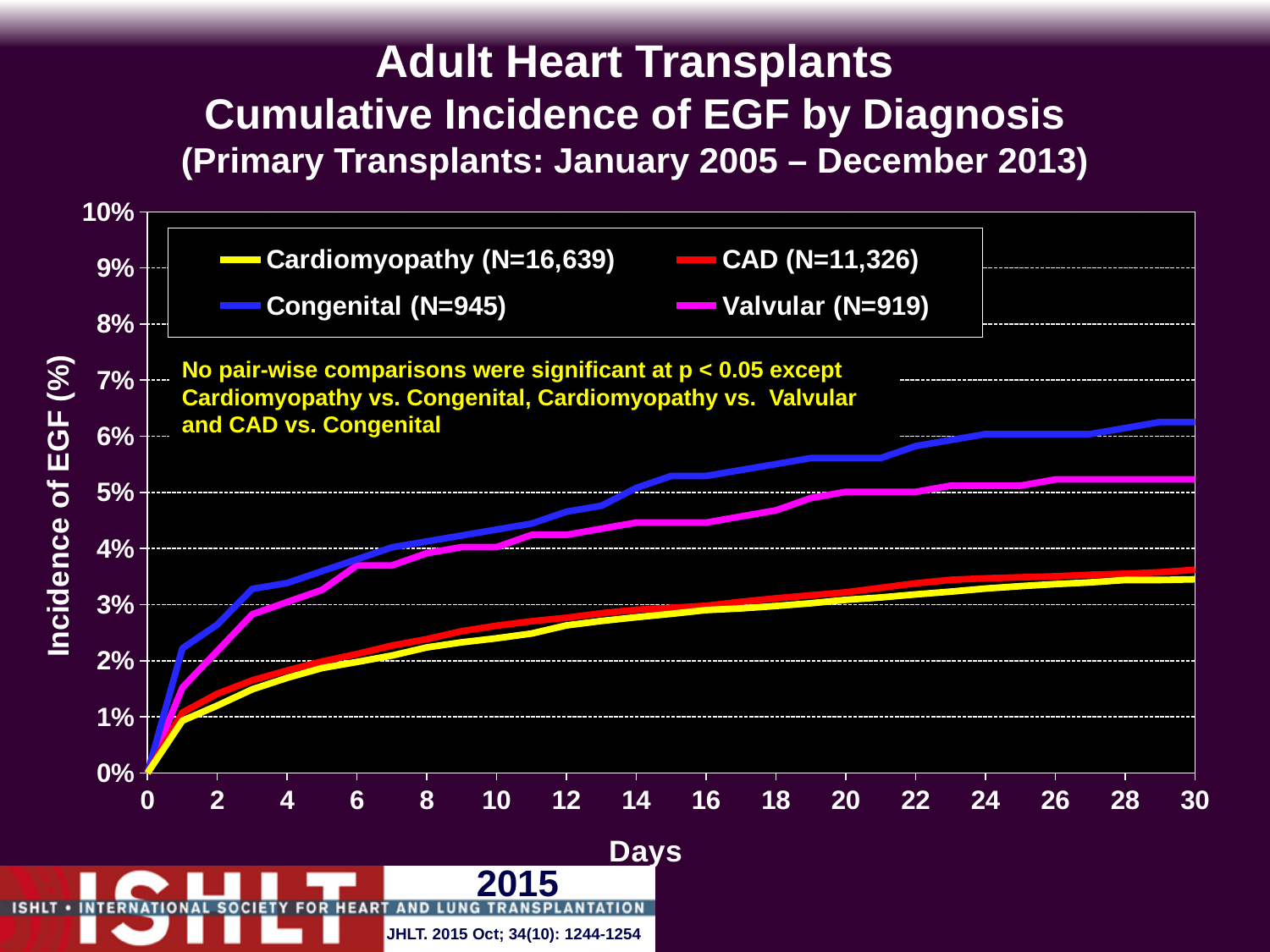
Which diagnosis group has the lowest cumulative incidence of EGF at day 30? Cardiomyopathy How many series does the legend list? 4 Is the cumulative incidence of EGF for Congenital at day 30 greater or less than 6%? greater Is the cumulative incidence of EGF for Cardiomyopathy at day 30 greater or less than 4%? less What kind of chart is shown on the slide? line chart What is the label of the y axis? Incidence of EGF (%) What is the N shown in the legend for Cardiomyopathy? N=16,639 Do the cumulative incidence curves rise or fall as the number of days increases? rise Is the cumulative incidence of EGF for Valvular at day 30 greater or less than 5%? greater Which diagnosis group has the highest cumulative incidence of EGF at day 30? Congenital At day 30, which has the higher cumulative incidence of EGF: Congenital or Valvular? Congenital